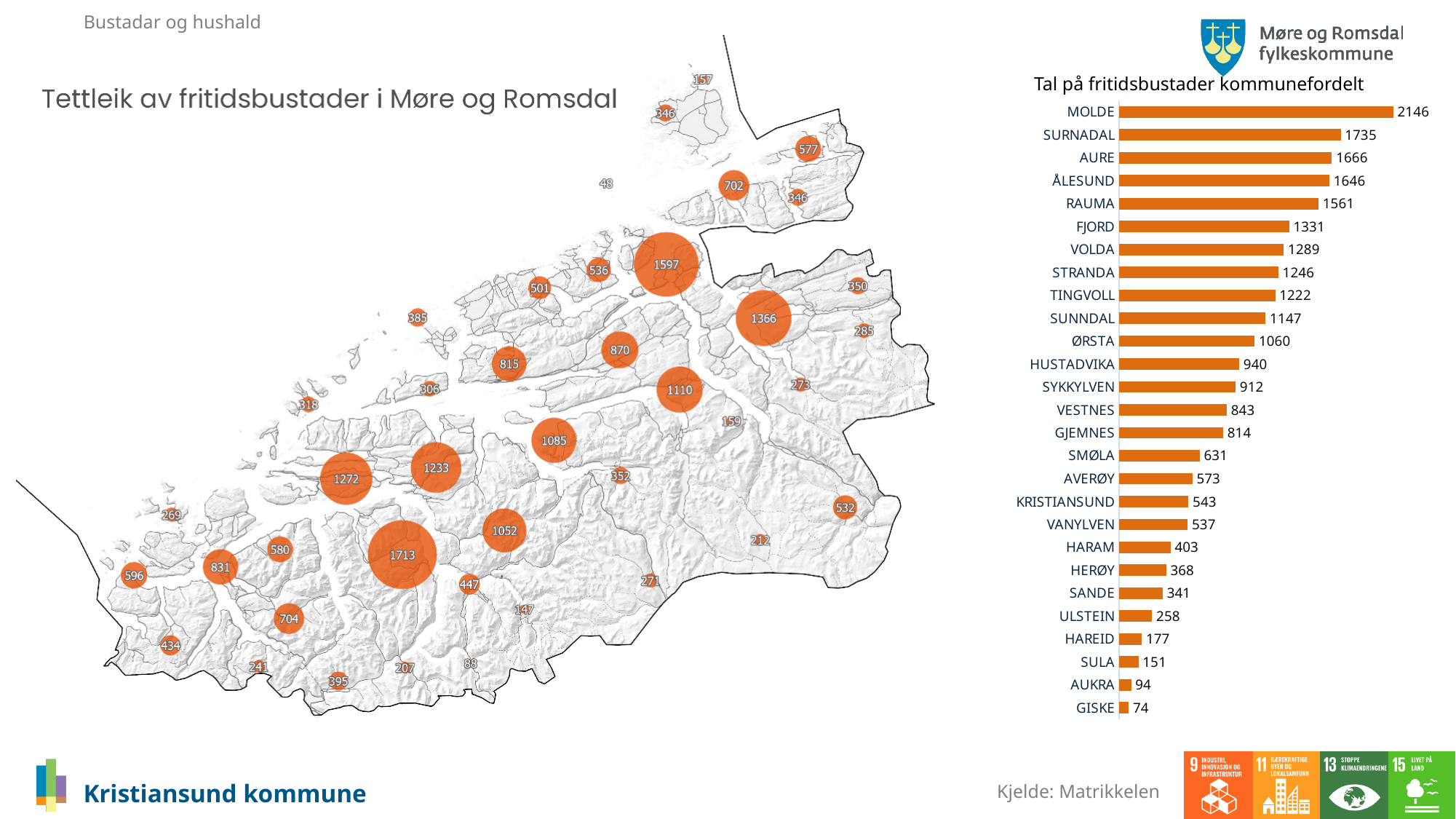
What kind of chart is 'Tal på fritidsbustader kommunefordelt'? Bar chart How many municipalities are listed in the bar chart 'Tal på fritidsbustader kommunefordelt'? 27 In the bar chart 'Tal på fritidsbustader kommunefordelt', what is the value for MOLDE? 2146 In the bar chart 'Tal på fritidsbustader kommunefordelt', which is larger, the value for VOLDA or the value for STRANDA? VOLDA What is the source cited at the bottom of the slide for the data? Matrikkelen In the bar chart 'Tal på fritidsbustader kommunefordelt', what is the value for HUSTADVIKA? 940 In the bar chart 'Tal på fritidsbustader kommunefordelt', which municipality has the highest value? MOLDE In the bar chart 'Tal på fritidsbustader kommunefordelt', which municipality has the lowest value? GISKE In the bar chart 'Tal på fritidsbustader kommunefordelt', what is the value for KRISTIANSUND? 543 In the bar chart 'Tal på fritidsbustader kommunefordelt', what is the difference between the values for MOLDE and GISKE? 2072 In the bar chart 'Tal på fritidsbustader kommunefordelt', what is the difference between the values for SURNADAL and AURE? 69 In the bar chart 'Tal på fritidsbustader kommunefordelt', which is larger, the value for SMØLA or the value for HARAM? SMØLA